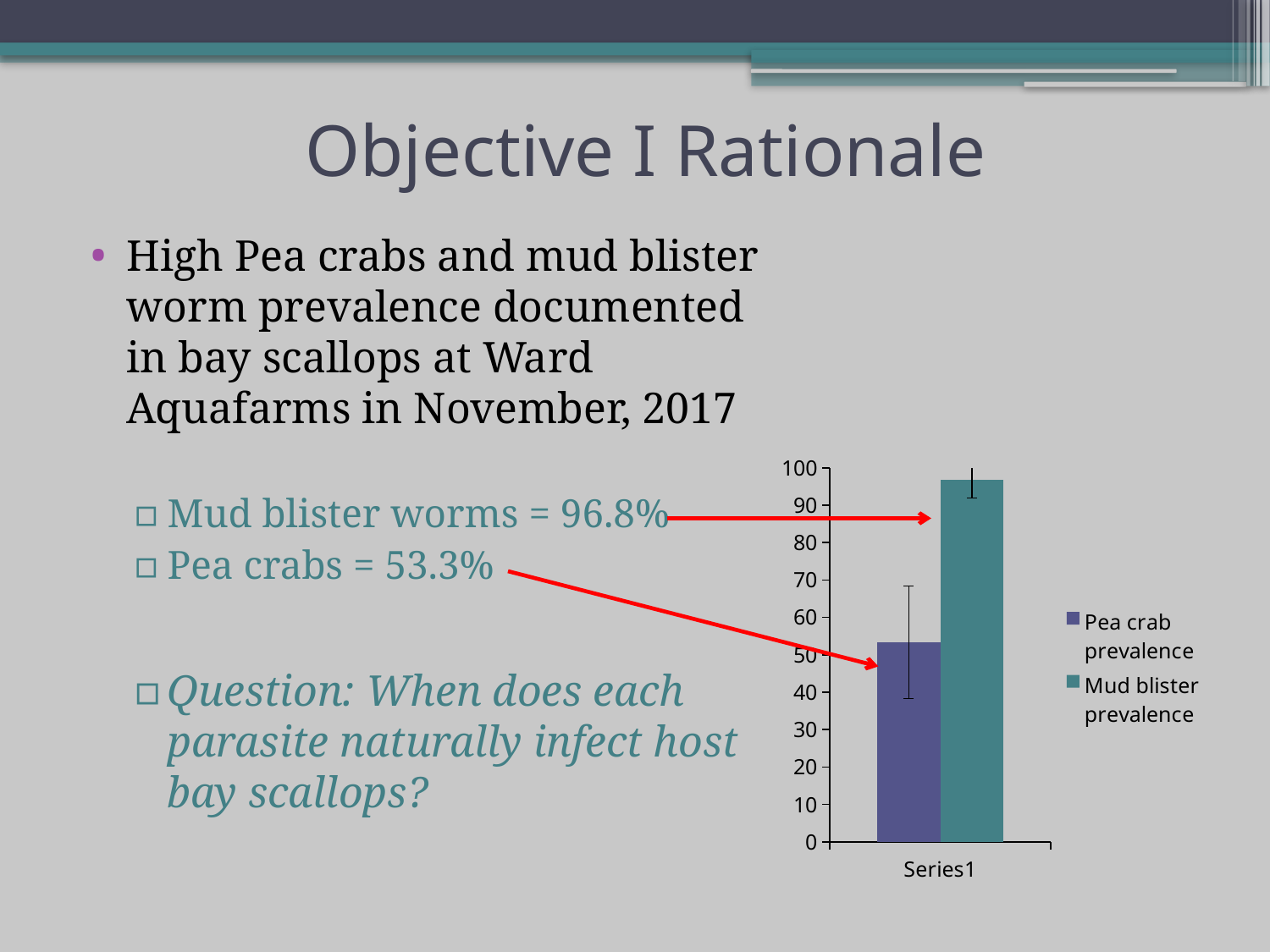
How many series does the chart legend list? 2 What is the category label shown on the x axis of the chart? Series1 Is the value for Mud blister prevalence greater or less than 90? greater What is the highest value shown on the chart's y axis? 100 According to the slide, what is the pea crab prevalence shown by the shorter bar? 53.3% What is the difference between the mud blister worm prevalence (96.8%) and the pea crab prevalence (53.3%) shown on the slide? 43.5% According to the slide, what is the mud blister worm prevalence shown by the taller bar? 96.8% Is the value for Pea crab prevalence greater or less than 60? less Is the value for Pea crab prevalence greater or less than 50? greater What kind of chart is shown on the slide? bar chart Which series has the taller bar, Pea crab prevalence or Mud blister prevalence? Mud blister prevalence Which series has the shorter bar in the chart? Pea crab prevalence